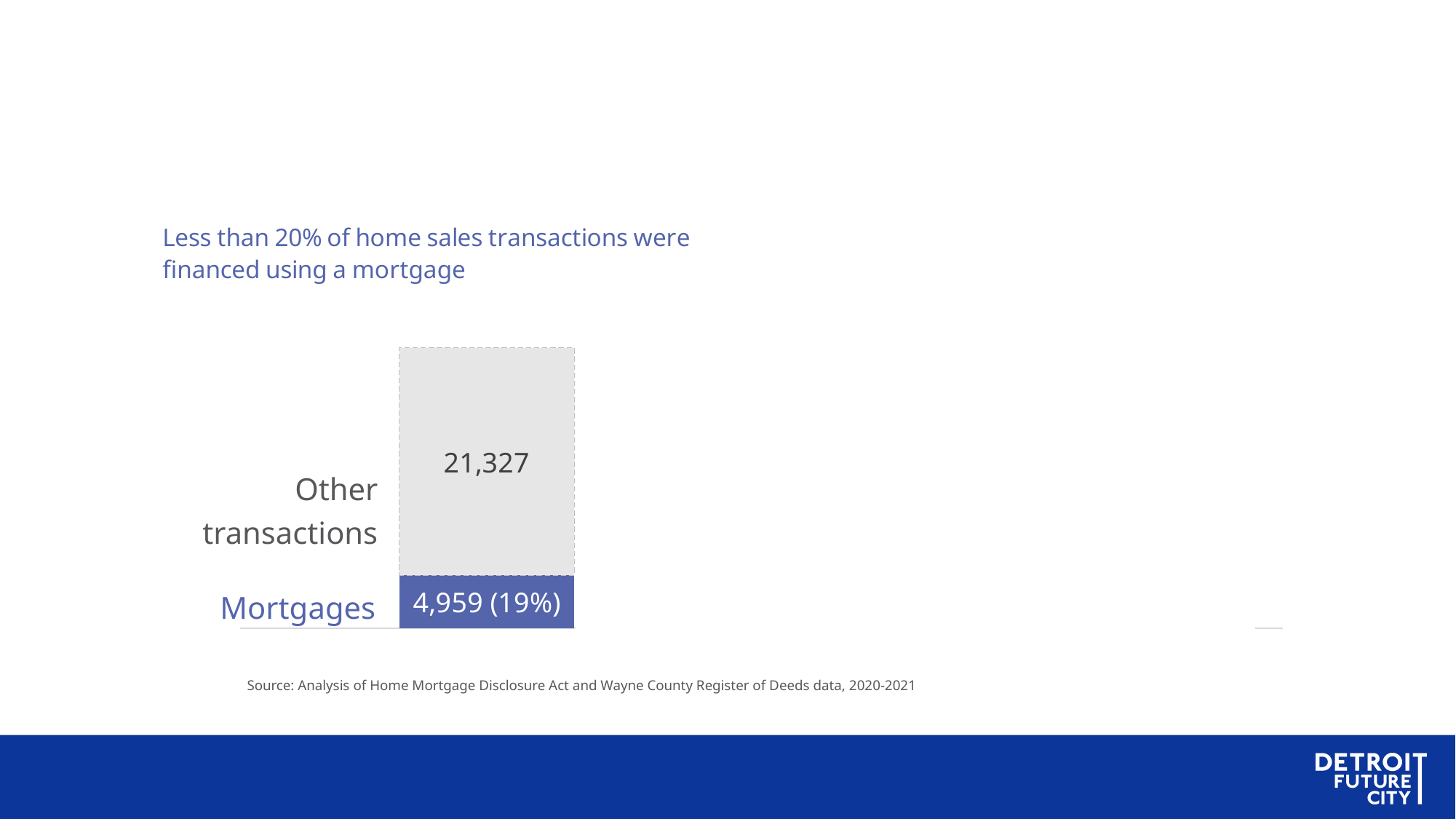
What is the title of the chart? Less than 20% of home sales transactions were financed using a mortgage What is the difference between Other transactions and Mortgages? 16,368 How many segments does the stacked bar have? 2 Which segment has the lowest value? Mortgages What percentage of transactions does the Mortgages segment represent? 19% Which segment has the highest value? Other transactions Which segment is shown in blue? Mortgages What is the total of the stacked bar? 26,286 What is the value for Other transactions? 21,327 What kind of chart is shown on the slide? Stacked bar chart Which segment is larger, Other transactions or Mortgages? Other transactions What is the value for Mortgages? 4,959